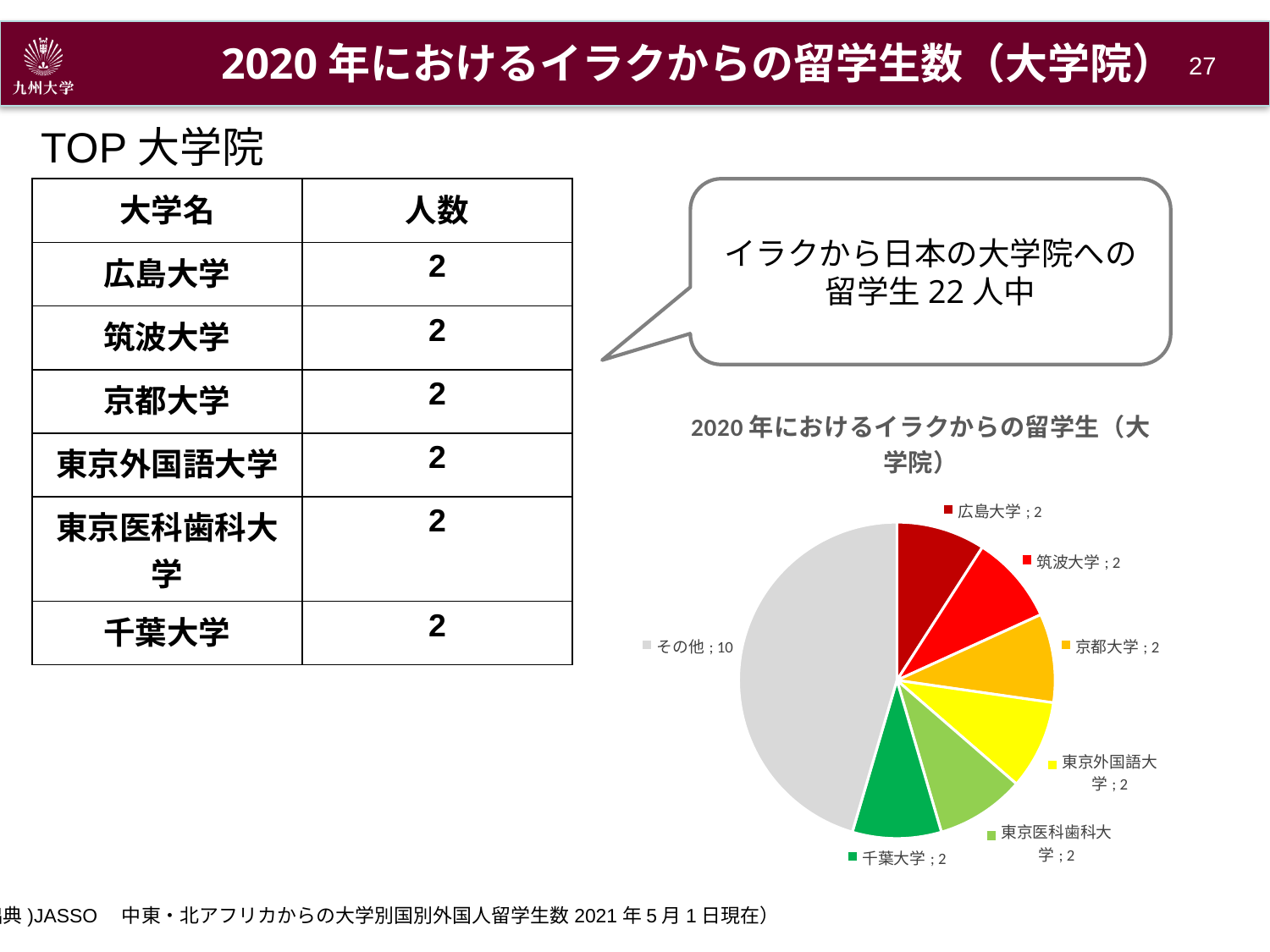
What share of the pie does 東京外国語大学 represent? 2/22 What is the total of all slices in the pie chart? 22 Which is larger, the value for その他 or the value for 筑波大学? その他 What is the value for その他 in the pie chart? 10 What is the value for 広島大学 in the pie chart? 2 What is the difference between the value for その他 and the value for 京都大学? 8 Which slice of the pie chart is the largest? その他 What is the title of the pie chart? 2020年におけるイラクからの留学生（大学院） What kind of chart is shown on the slide? pie chart How many slices does the pie chart have? 7 What is the value for 千葉大学 in the pie chart? 2 What colour is the その他 slice in the pie chart? grey